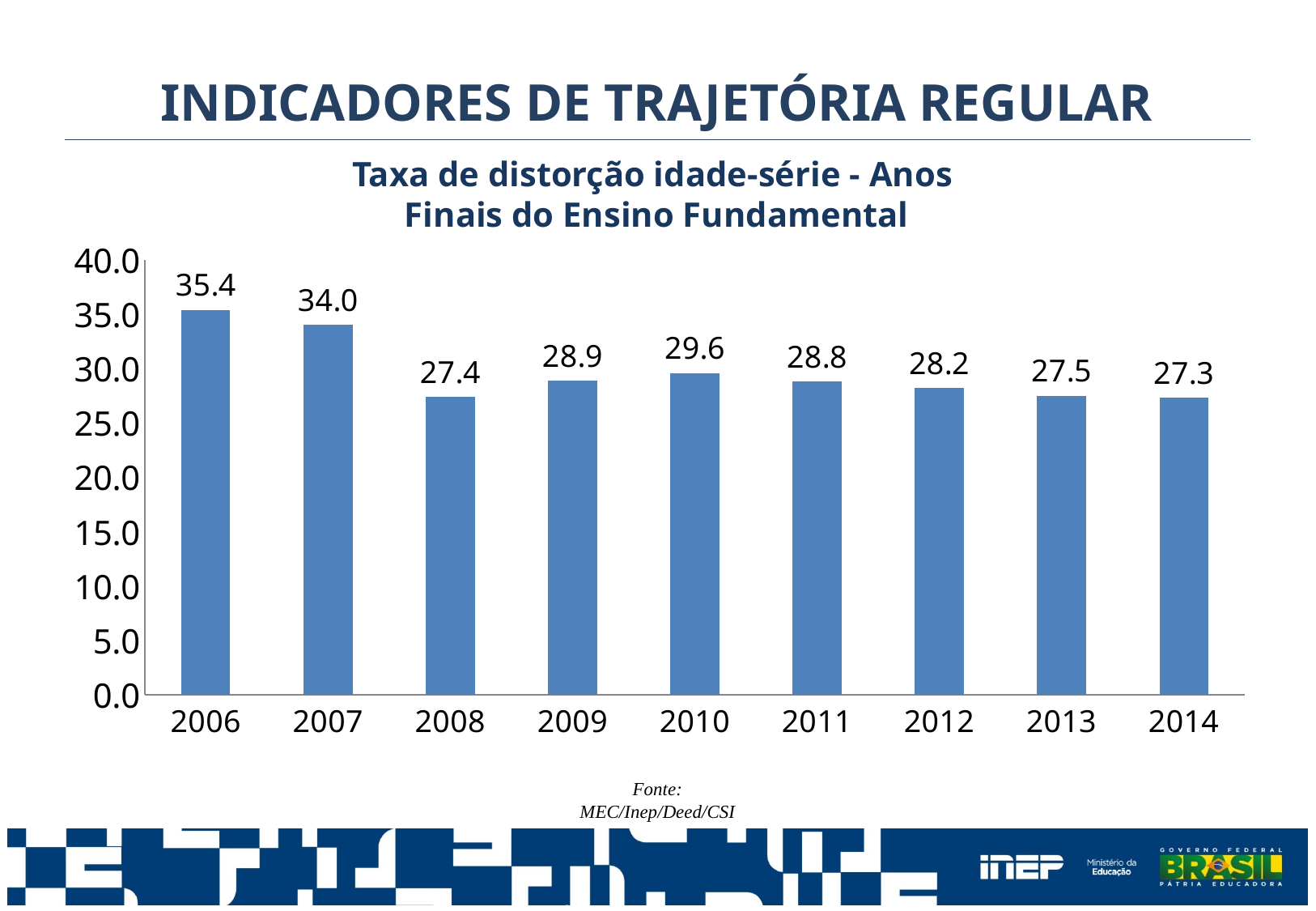
What kind of chart is this? bar chart What is the value for 2010? 29.6 Which year has the lowest value? 2014 Which year has the highest value? 2006 What is the title of the chart? Taxa de distorção idade-série - Anos Finais do Ensino Fundamental Which is larger, the value for 2009 or the value for 2012? 2009 What is the value for 2006? 35.4 What is the difference between the values for 2006 and 2014? 8.1 Is the value for 2011 greater or less than 30.0? less What is the difference between the values for 2007 and 2008? 6.6 What is the value for 2014? 27.3 How many years are shown on the x axis? 9